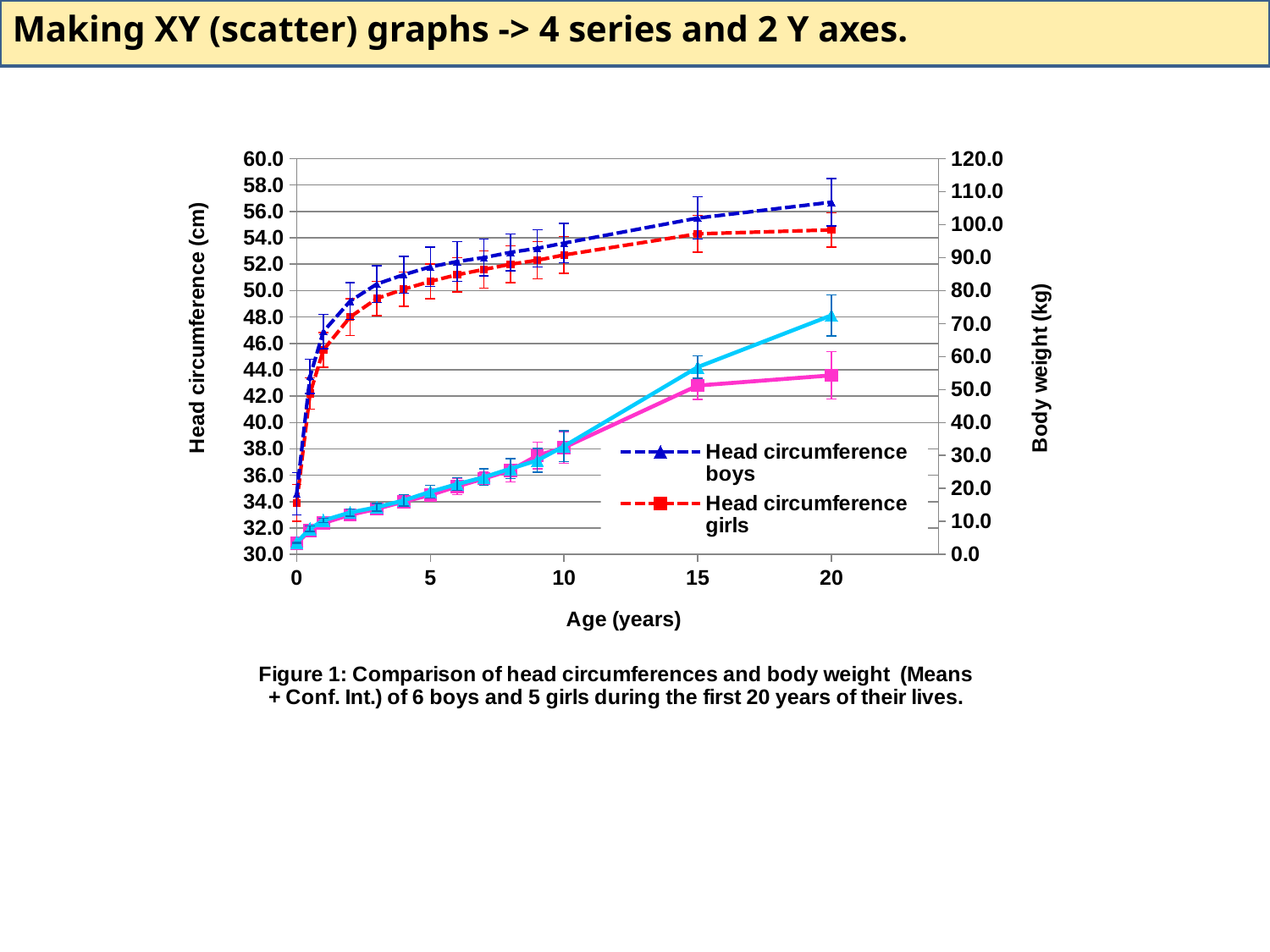
How many series does the legend list? 2 At age 20, which series has the larger head circumference, boys or girls? Head circumference boys Is the Head circumference boys value at age 20 greater or less than 54.0? greater What is the title of the left vertical axis? Head circumference (cm) Does the Head circumference boys series rise or fall as age increases? rise At age 1, which series has the larger head circumference, boys or girls? Head circumference boys Is the Head circumference girls value at age 20 greater or less than 56.0? less Is the Head circumference boys value at age 10 greater or less than 52.0? greater What is the title of the right vertical axis? Body weight (kg) What kind of chart is shown on the slide? XY scatter chart